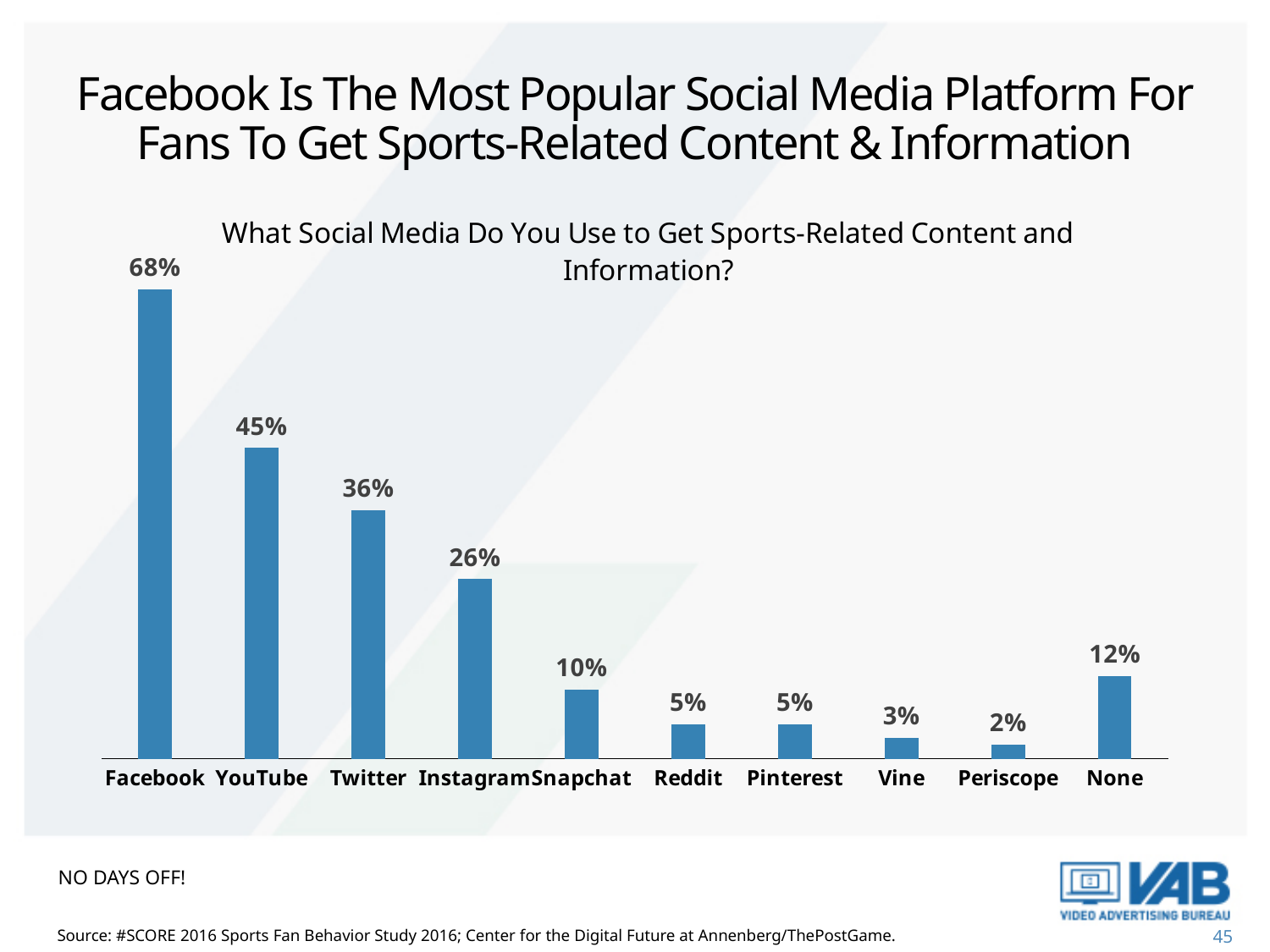
What kind of chart is shown on the slide? Bar chart What is the difference between the values for Twitter and Instagram? 10% Which platform has the lowest value in the chart? Periscope Which has a larger value, Instagram or None? Instagram What percentage of respondents answered None? 12% What is the value shown for Snapchat? 10% What is the title of the chart? What Social Media Do You Use to Get Sports-Related Content and Information? How many categories are shown on the x axis of the chart? 10 Which platform has the highest value in the chart? Facebook What is the difference between the values for Facebook and YouTube? 23% What percentage of fans use Facebook to get sports-related content and information? 68% Which has a larger value, Vine or Periscope? Vine